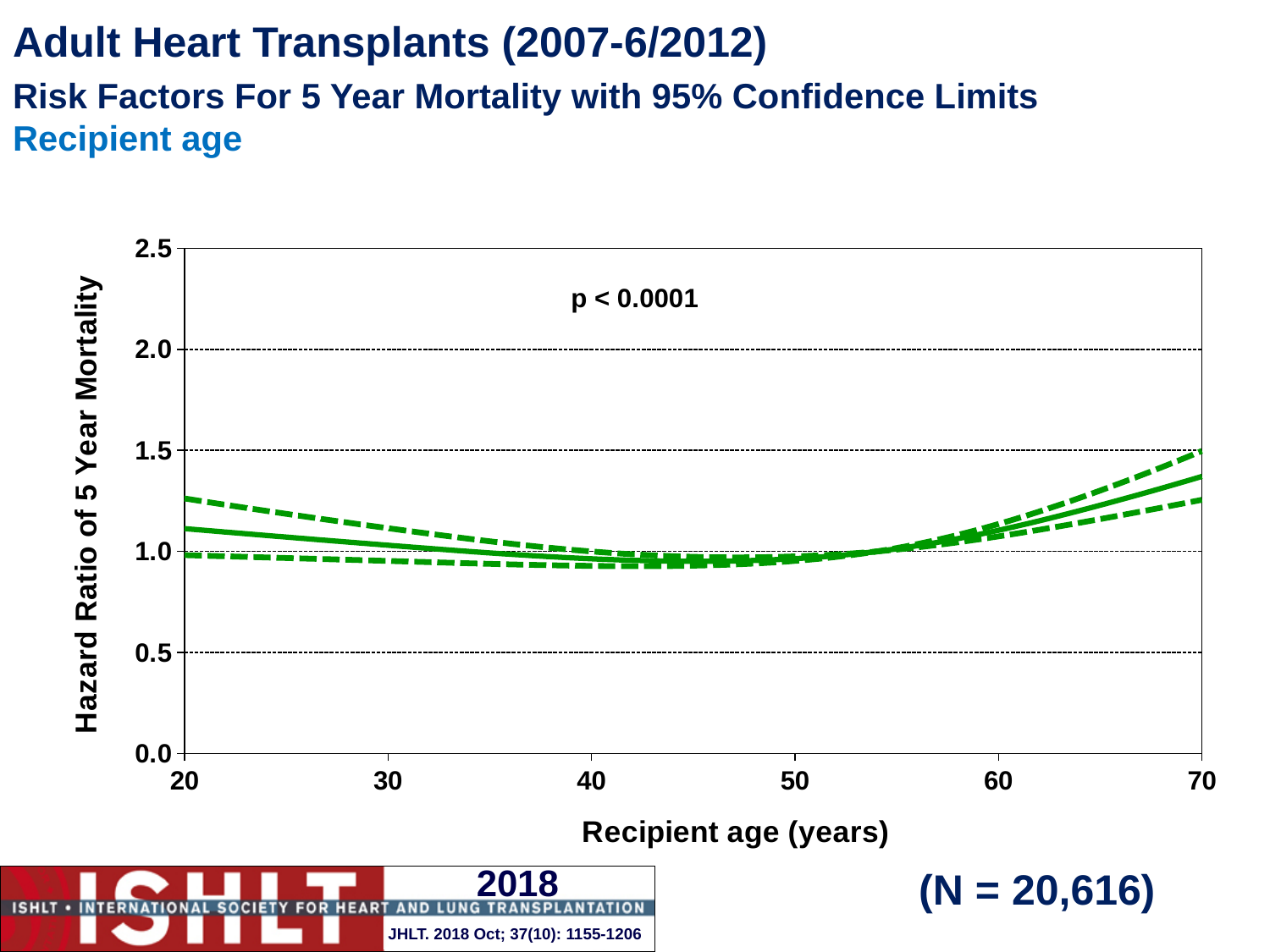
Is the upper confidence limit (upper dashed line) at recipient age 20 greater or less than 1.0? greater Is the hazard ratio (solid line) at recipient age 70 greater or less than 1.0? greater Is the hazard ratio (solid line) at recipient age 45 greater or less than 1.0? less How many lines are plotted on the chart? 3 What is the label of the x axis? Recipient age (years) What kind of chart is shown on the slide? line chart Does the hazard ratio (solid line) rise or fall as recipient age increases from 50 to 70 years? rise Which recipient age has the higher hazard ratio on the solid line, 45 or 70? 70 Does the hazard ratio (solid line) rise or fall as recipient age increases from 20 to 45 years? fall What is the label of the y axis? Hazard Ratio of 5 Year Mortality